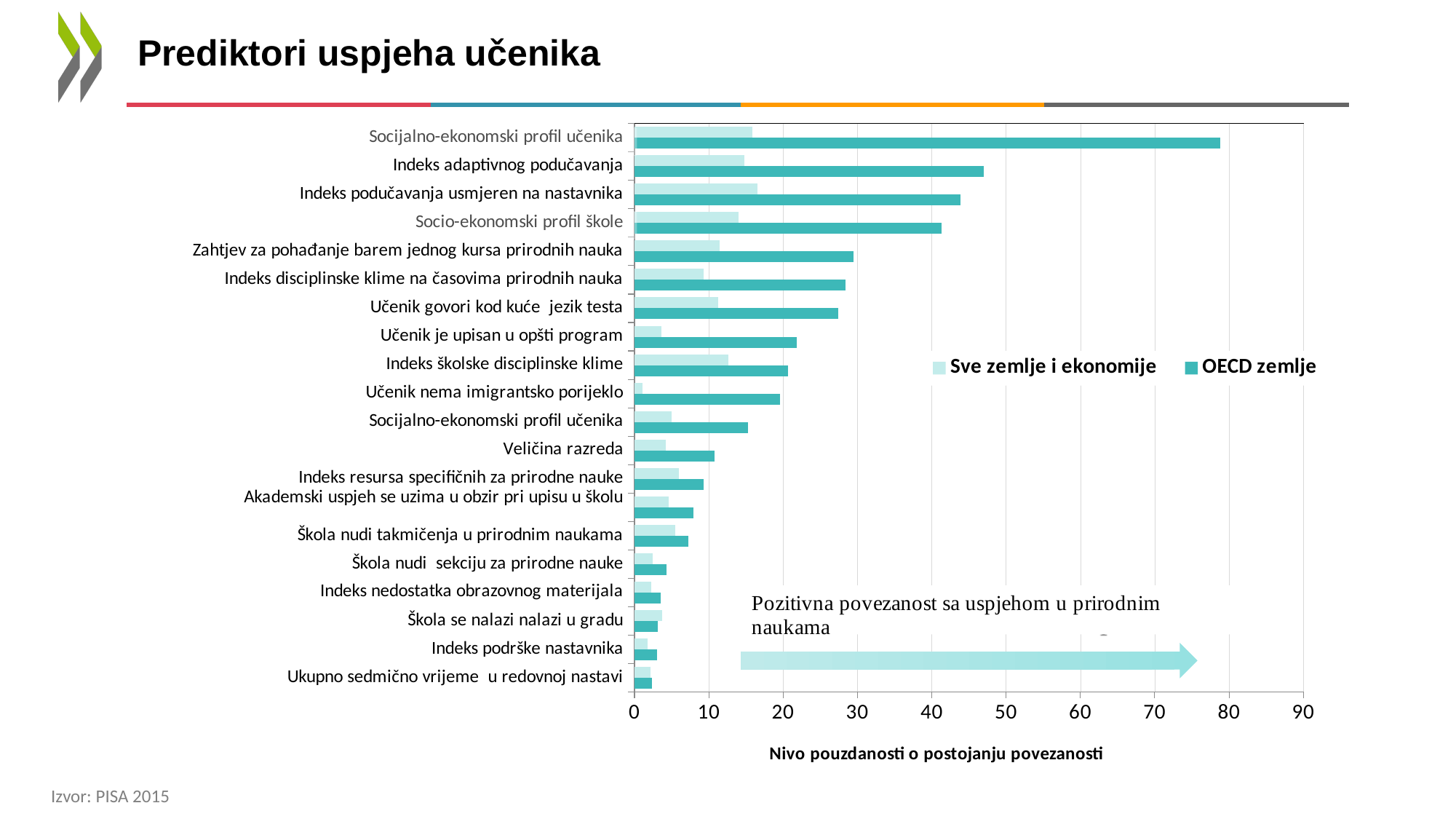
For the Sve zemlje i ekonomije series, which is larger: Učenik je upisan u opšti program or Indeks školske disciplinske klime? Indeks školske disciplinske klime Is the Sve zemlje i ekonomije value for Učenik nema imigrantsko porijeklo greater or less than 10? less Which category has the highest value for OECD zemlje? Socijalno-ekonomski profil učenika What are the two series named in the legend? Sve zemlje i ekonomije; OECD zemlje For Socijalno-ekonomski profil učenika (top bar), which series has the larger value: Sve zemlje i ekonomije or OECD zemlje? OECD zemlje Is the OECD zemlje value for Indeks adaptivnog podučavanja greater or less than 40? greater How many categories are plotted on the chart? 20 What kind of chart is shown on the slide? bar chart Is the OECD zemlje value for Socijalno-ekonomski profil učenika (top bar) greater or less than 70? greater What is the title of the horizontal axis? Nivo pouzdanosti o postojanju povezanosti How many series does the legend list? 2